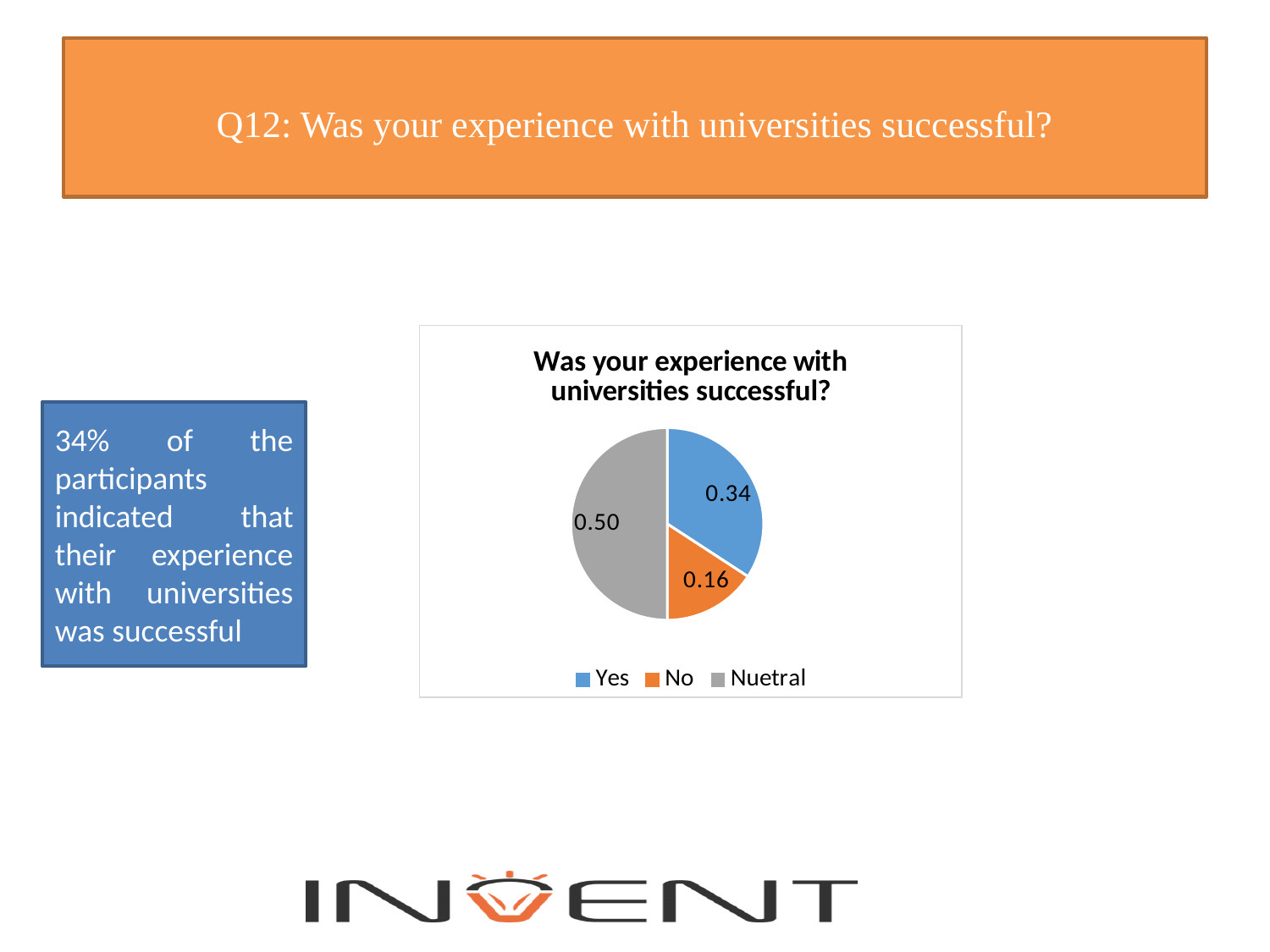
What is the difference between the values for Nuetral and Yes? 0.16 How many categories does the pie chart show? 3 What kind of chart is shown on the slide? pie chart What is the value for Nuetral in the pie chart? 0.50 Which category has the smallest slice in the pie chart? No Which category has the largest slice in the pie chart? Nuetral What is the value for No in the pie chart? 0.16 What is the difference between the values for Yes and No? 0.18 Which colour represents No in the pie chart? orange What is the value for Yes in the pie chart? 0.34 What is the title of the chart? Was your experience with universities successful? Which is larger, the value for Yes or the value for No? Yes